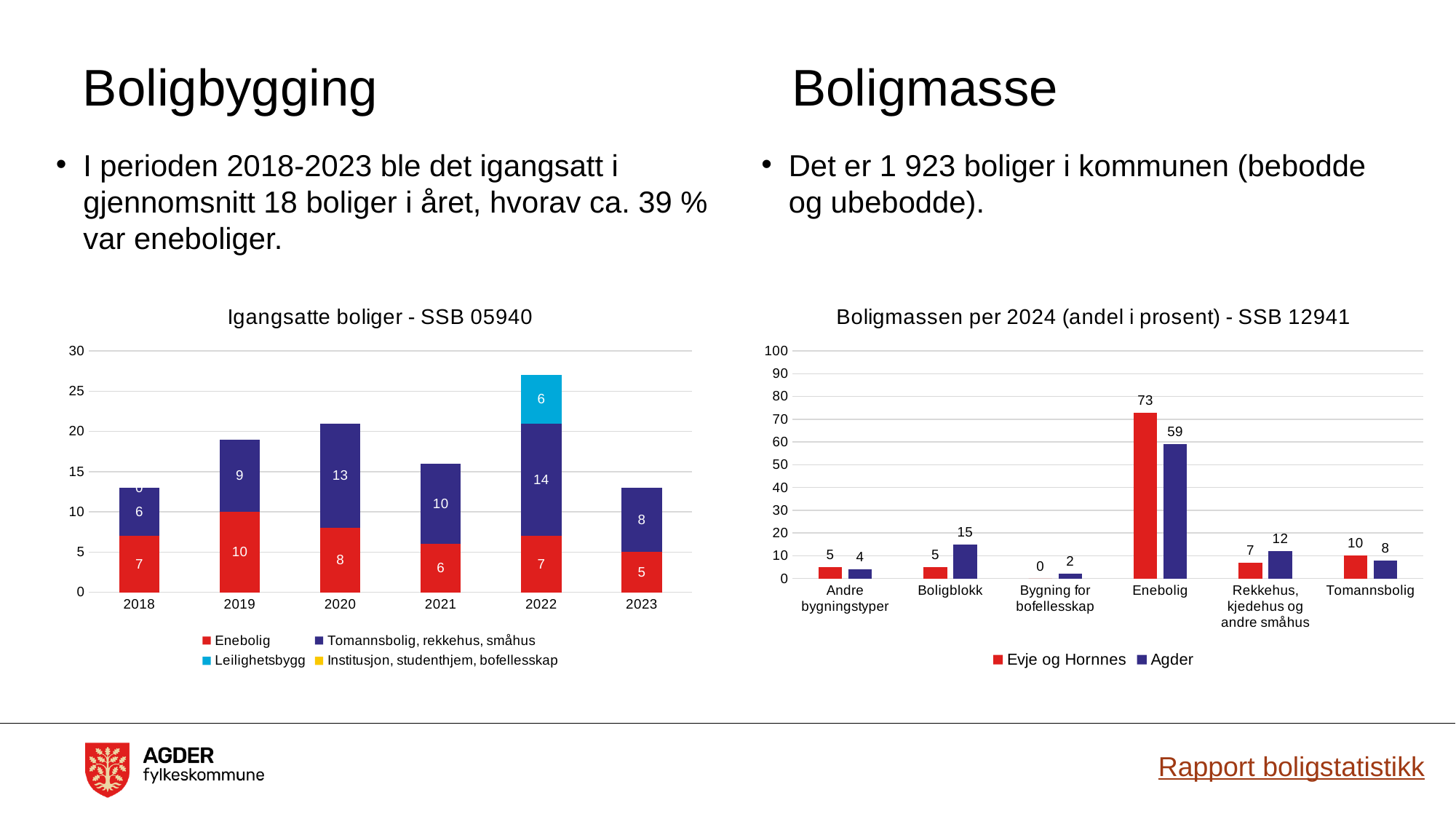
In the chart 'Boligmassen per 2024 (andel i prosent) - SSB 12941', what is the value for Agder for Enebolig? 59 In the chart 'Boligmassen per 2024 (andel i prosent) - SSB 12941', what is the difference between Evje og Hornnes and Agder for Enebolig? 14 In the chart 'Igangsatte boliger - SSB 05940', what is the value for Enebolig in 2019? 10 In the chart 'Igangsatte boliger - SSB 05940', what is the value for Tomannsbolig, rekkehus, småhus in 2022? 14 In the chart 'Igangsatte boliger - SSB 05940', which year has the highest total stacked bar? 2022 What kind of chart is 'Boligmassen per 2024 (andel i prosent) - SSB 12941'? Bar chart In the chart 'Igangsatte boliger - SSB 05940', what is the total of the stacked bar for 2020? 21 In the chart 'Boligmassen per 2024 (andel i prosent) - SSB 12941', which is larger for Boligblokk: Evje og Hornnes or Agder? Agder In the chart 'Igangsatte boliger - SSB 05940', what is the total of the stacked bar for 2022? 27 In the chart 'Boligmassen per 2024 (andel i prosent) - SSB 12941', how many categories are shown on the x axis? 6 In the chart 'Igangsatte boliger - SSB 05940', how many series does the legend list? 4 In the chart 'Boligmassen per 2024 (andel i prosent) - SSB 12941', which category has the lowest value for Evje og Hornnes? Bygning for bofellesskap